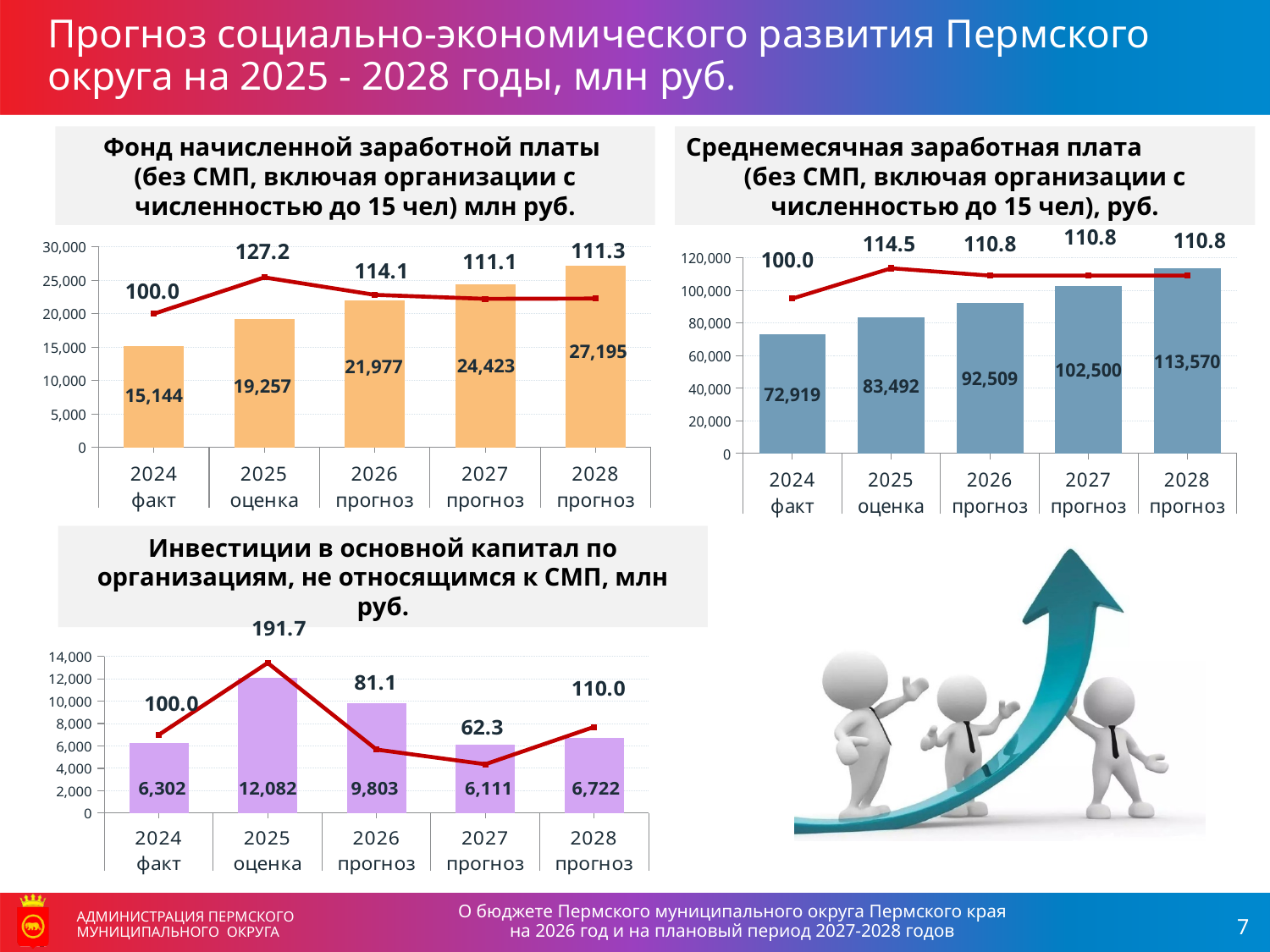
In the chart 'Фонд начисленной заработной платы', do the bar values rise or fall from 2024 to 2028? rise In the chart 'Среднемесячная заработная плата', what is the value of the bar for 2026 прогноз? 92,509 In the chart 'Фонд начисленной заработной платы', what is the value of the bar for 2028 прогноз? 27,195 In the chart 'Среднемесячная заработная плата', what is the difference between the 2027 прогноз and 2026 прогноз bar values? 9,991 In the chart 'Фонд начисленной заработной платы', what is the line value shown above the 2025 оценка bar? 127.2 What type of chart is 'Инвестиции в основной капитал'? bar chart with a line In the chart 'Инвестиции в основной капитал', which year has the highest bar value? 2025 оценка In the chart 'Среднемесячная заработная плата', how many bars are plotted? 5 In the chart 'Инвестиции в основной капитал', what is the line value shown above the 2027 прогноз bar? 62.3 In the chart 'Фонд начисленной заработной платы', what is the difference between the 2028 прогноз bar and the 2024 факт bar? 12,051 In the chart 'Среднемесячная заработная плата', which year has the lowest bar value? 2024 факт In the chart 'Инвестиции в основной капитал', which bar is larger: 2026 прогноз or 2028 прогноз? 2026 прогноз